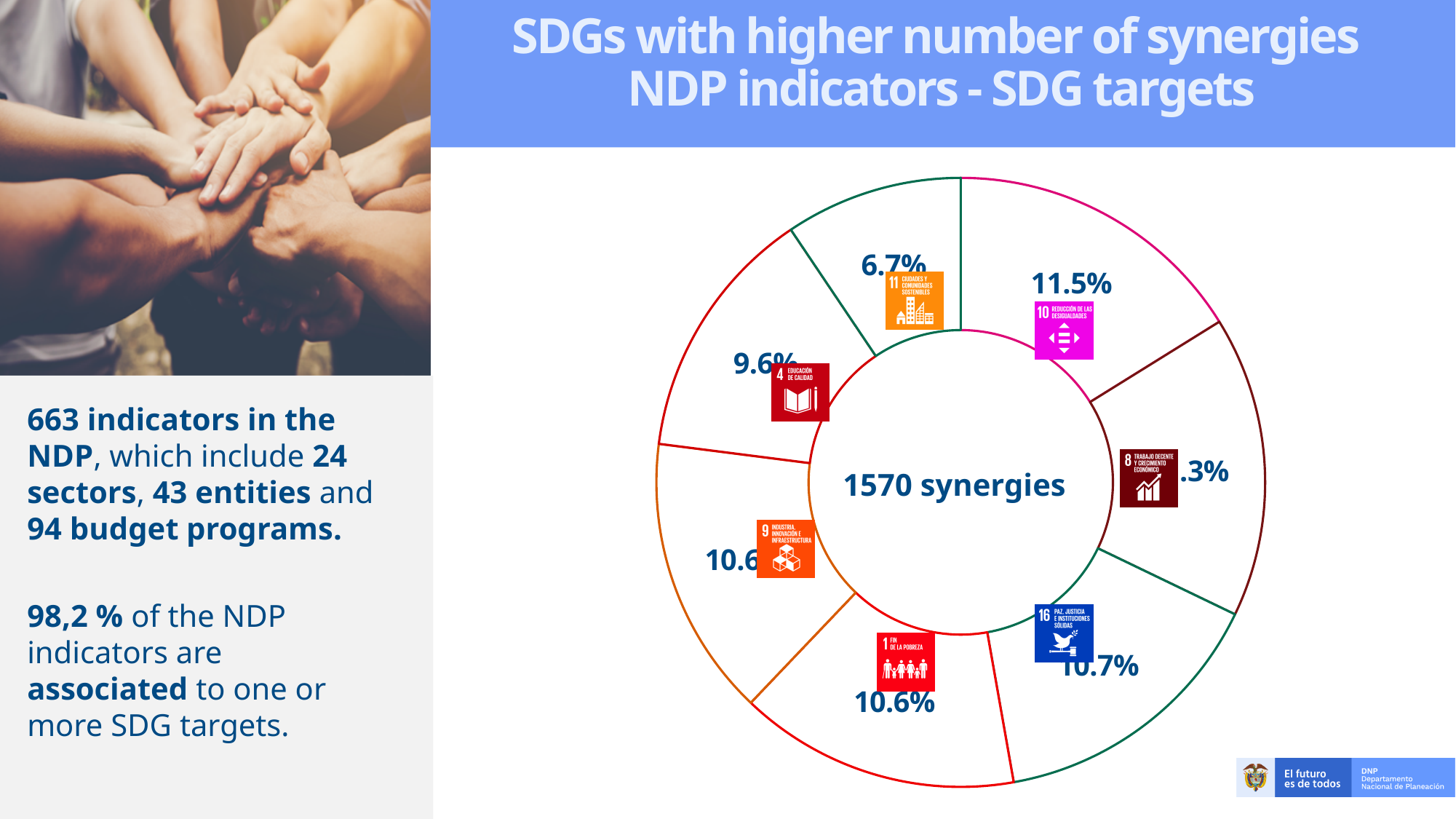
What percentage is shown for SDG 16 (Paz, justicia e instituciones sólidas)? 10.7% What percentage is shown for SDG 4 (Educación de calidad)? 9.6% What is the title of the slide containing the chart? SDGs with higher number of synergies NDP indicators - SDG targets What is the difference between the percentages for SDG 10 and SDG 11? 4.8% What is the difference between the percentages for SDG 16 and SDG 1? 0.1% Which has the larger percentage, SDG 10 or SDG 4? SDG 10 What total number of synergies is written in the centre of the chart? 1570 synergies What percentage is shown for SDG 11 (Ciudades y comunidades sostenibles)? 6.7% What kind of chart is shown on the slide? doughnut chart What percentage is shown for SDG 10 (Reducción de las desigualdades)? 11.5% What percentage is shown for SDG 1 (Fin de la pobreza)? 10.6% Which has the smaller percentage, SDG 11 or SDG 4? SDG 11